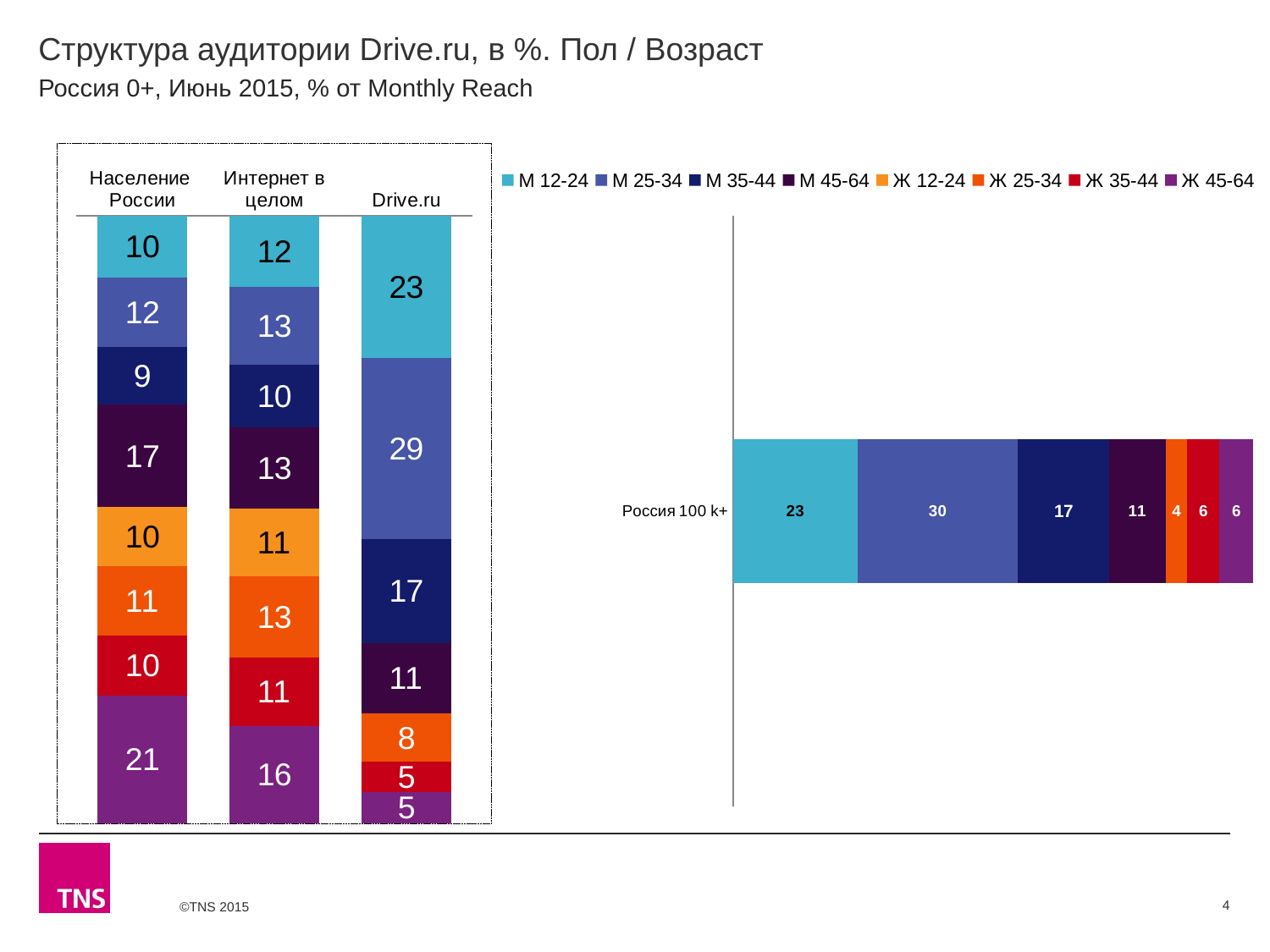
In the left chart, what is the value of the Ж 45-64 segment for Население России? 21 What kind of chart is shown on the left of the slide? Stacked bar chart In the right chart, what is the value of the М 35-44 segment for Россия 100 k+? 17 In the left chart, which is larger: the Ж 45-64 value for Население России or for Интернет в целом? Население России In the left chart, what is the value of the М 45-64 segment for Интернет в целом? 13 In the right chart, what is the value of the М 25-34 segment for Россия 100 k+? 30 In the left chart, what is the value of the М 12-24 segment for Drive.ru? 23 In the left chart, what is the difference between the М 12-24 values for Drive.ru and Население России? 13 How many series does the legend list? 8 In the left chart, what is the value of the М 25-34 segment for Drive.ru? 29 In the left chart, which segment is the largest in the Drive.ru bar? М 25-34 In the left chart, which segment is the largest in the Население России bar? Ж 45-64